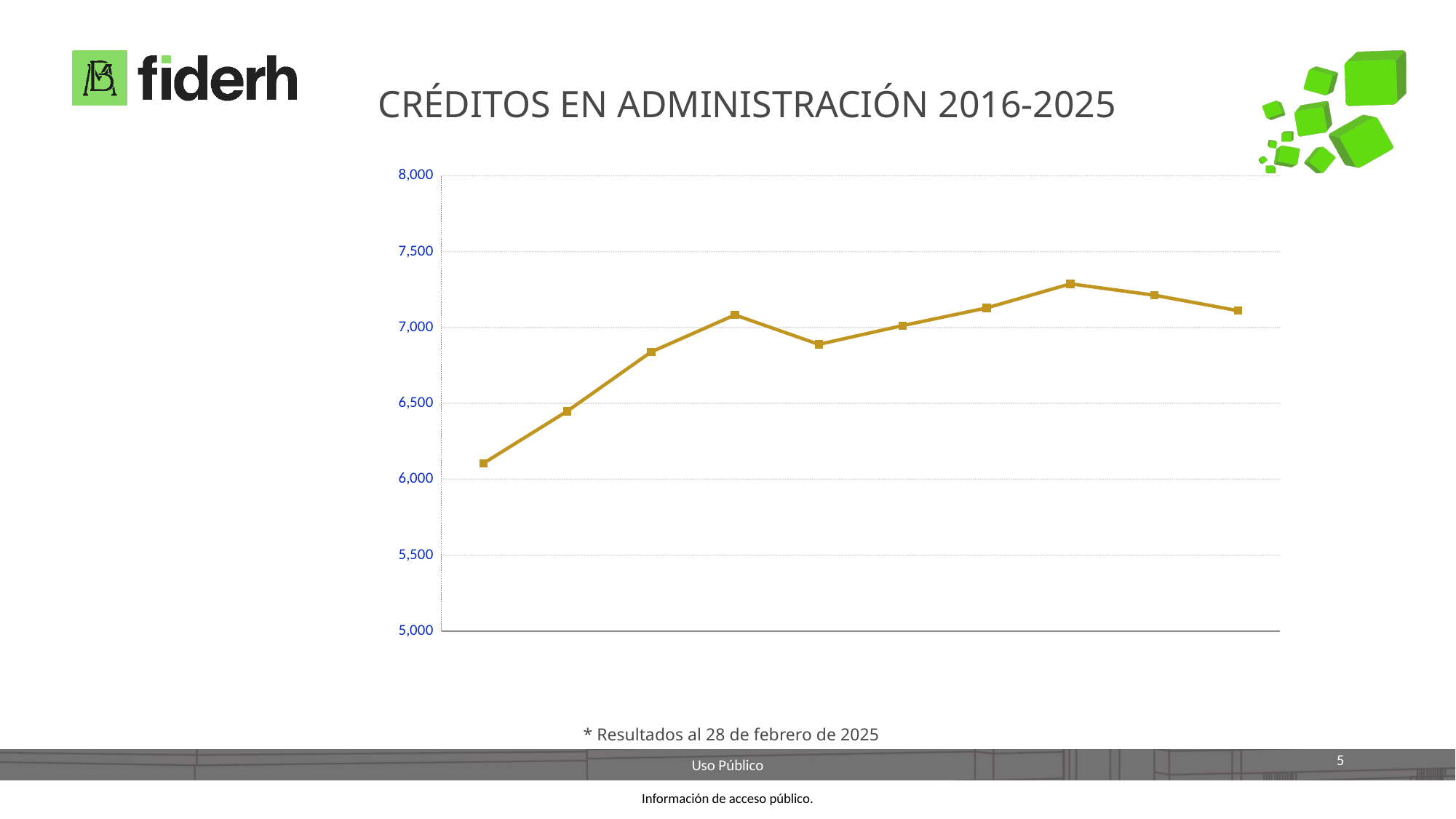
Is the value of the fifth point from the left greater or less than 7,000? less Is the value of the highest point on the line greater or less than 7,500? less What kind of chart is shown on the slide? line chart Overall, do the values rise or fall from the left of the chart to the right? rise Which point on the line has the lowest value: the first, the fifth, or the last? the first Is the value of the last (rightmost) point greater or less than 7,000? greater Which is larger, the value of the first point or the value of the last point? the last point How many data points are plotted on the line? 10 What is the title of the chart? CRÉDITOS EN ADMINISTRACIÓN 2016-2025 Which point on the line has the highest value, counting from the left? the eighth point